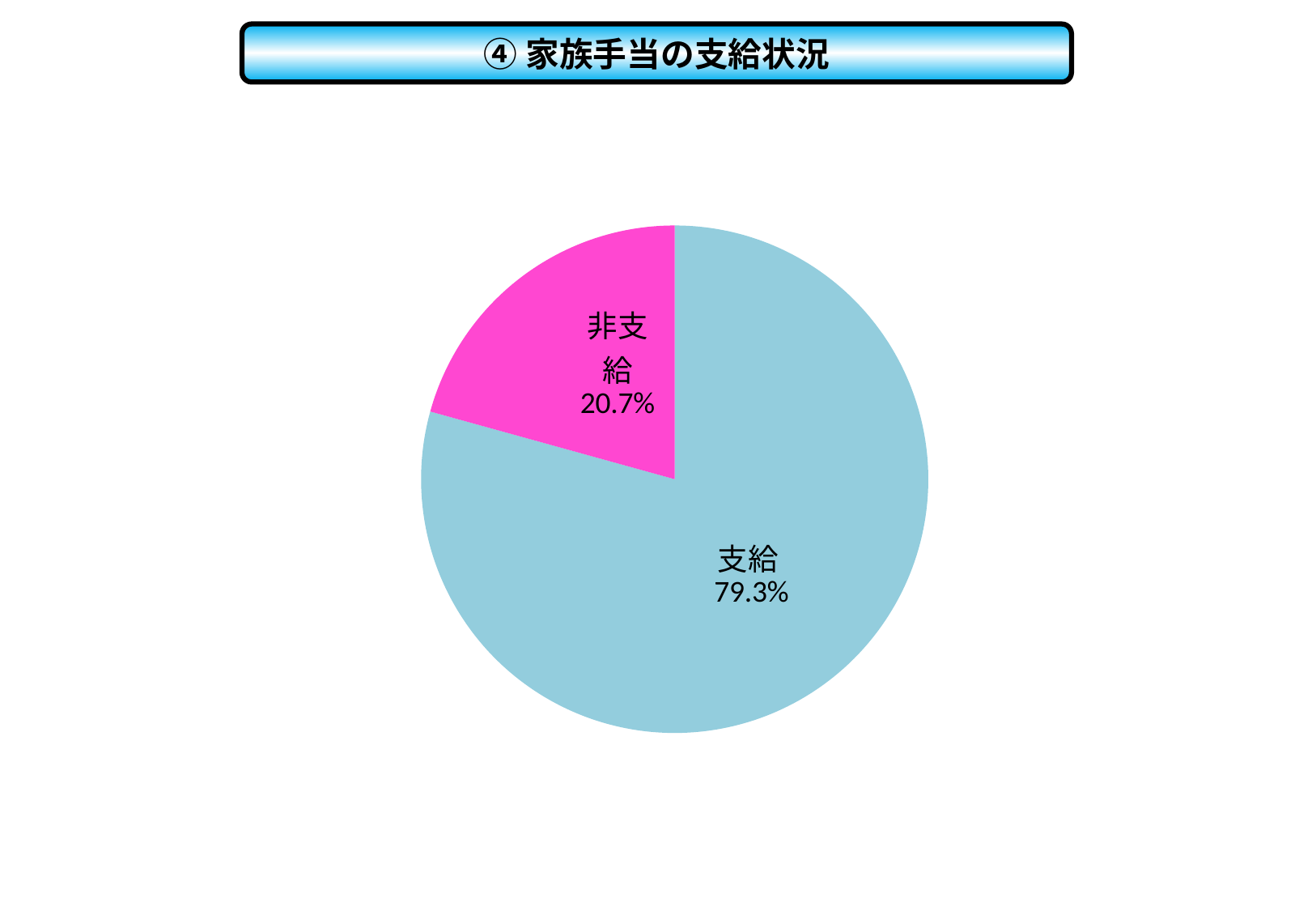
Which is larger, 支給 or 非支給? 支給 Which slice is the smallest? 非支給 What share of the pie does 支給 represent? 79.3% What colour is the 非支給 slice? pink What kind of chart is shown on the slide? pie chart Which slice is the largest? 支給 What is the difference in percentage points between 支給 and 非支給? 58.6 What is the title of the slide? ④ 家族手当の支給状況 What share of the pie does 非支給 represent? 20.7% How many slices does the pie chart have? 2